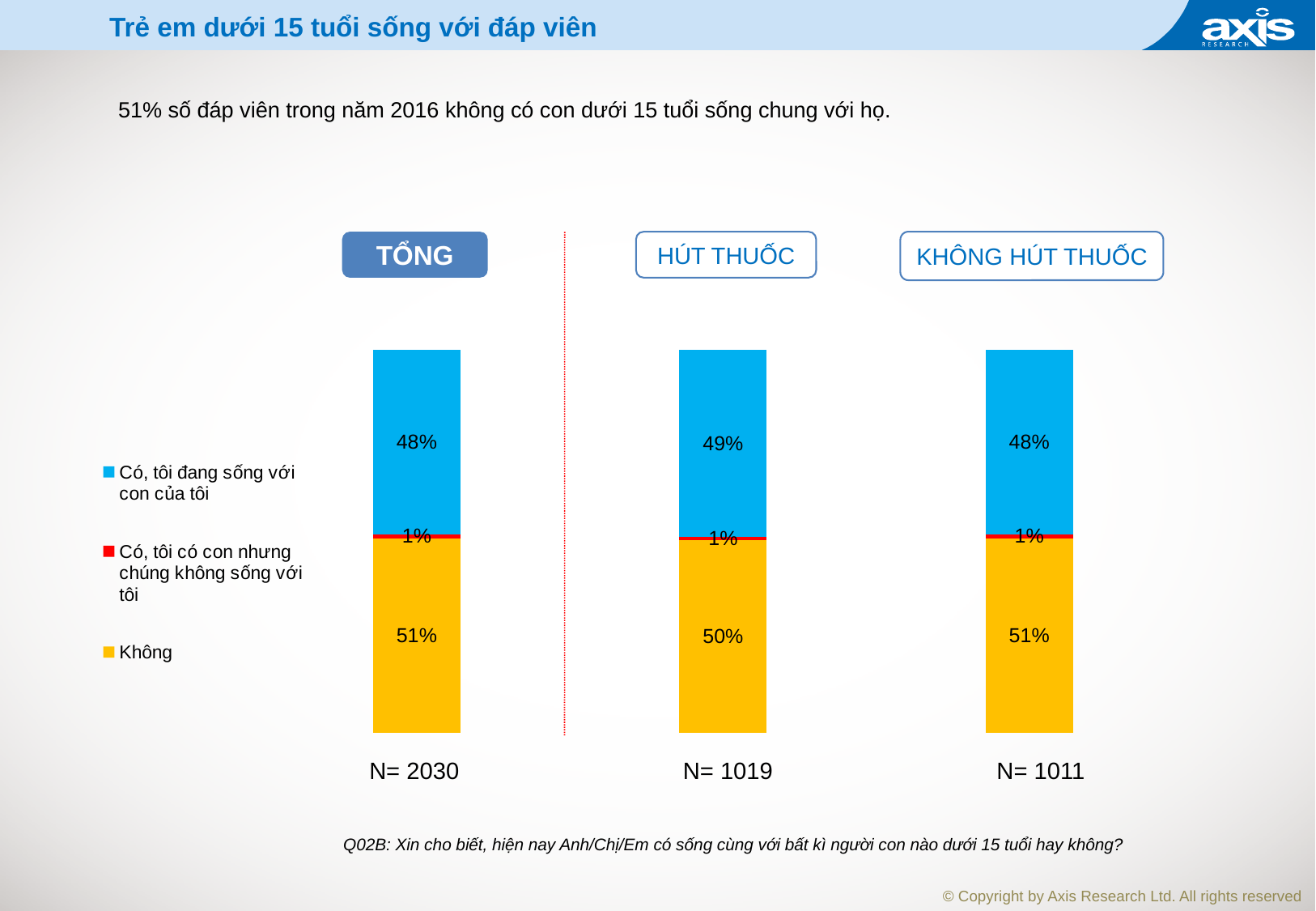
How many series does the legend list? 3 What is the sample size (N) for the TỔNG group? N= 2030 What percentage of respondents in the TỔNG group answered "Không"? 51% What percentage of the HÚT THUỐC group answered "Không"? 50% Which group has the highest share of "Có, tôi đang sống với con của tôi"? HÚT THUỐC In the HÚT THUỐC group, which is larger: the "Không" share or the "Có, tôi đang sống với con của tôi" share? Không How many groups (bars) are shown in the chart? 3 Which group has the lowest share of "Không"? HÚT THUỐC What kind of chart is shown on the slide? Stacked bar chart What is the difference between the "Không" share and the "Có, tôi đang sống với con của tôi" share in the TỔNG group? 3 percentage points What percentage of the HÚT THUỐC group answered "Có, tôi đang sống với con của tôi"? 49% What percentage of the KHÔNG HÚT THUỐC group answered "Có, tôi có con nhưng chúng không sống với tôi"? 1%